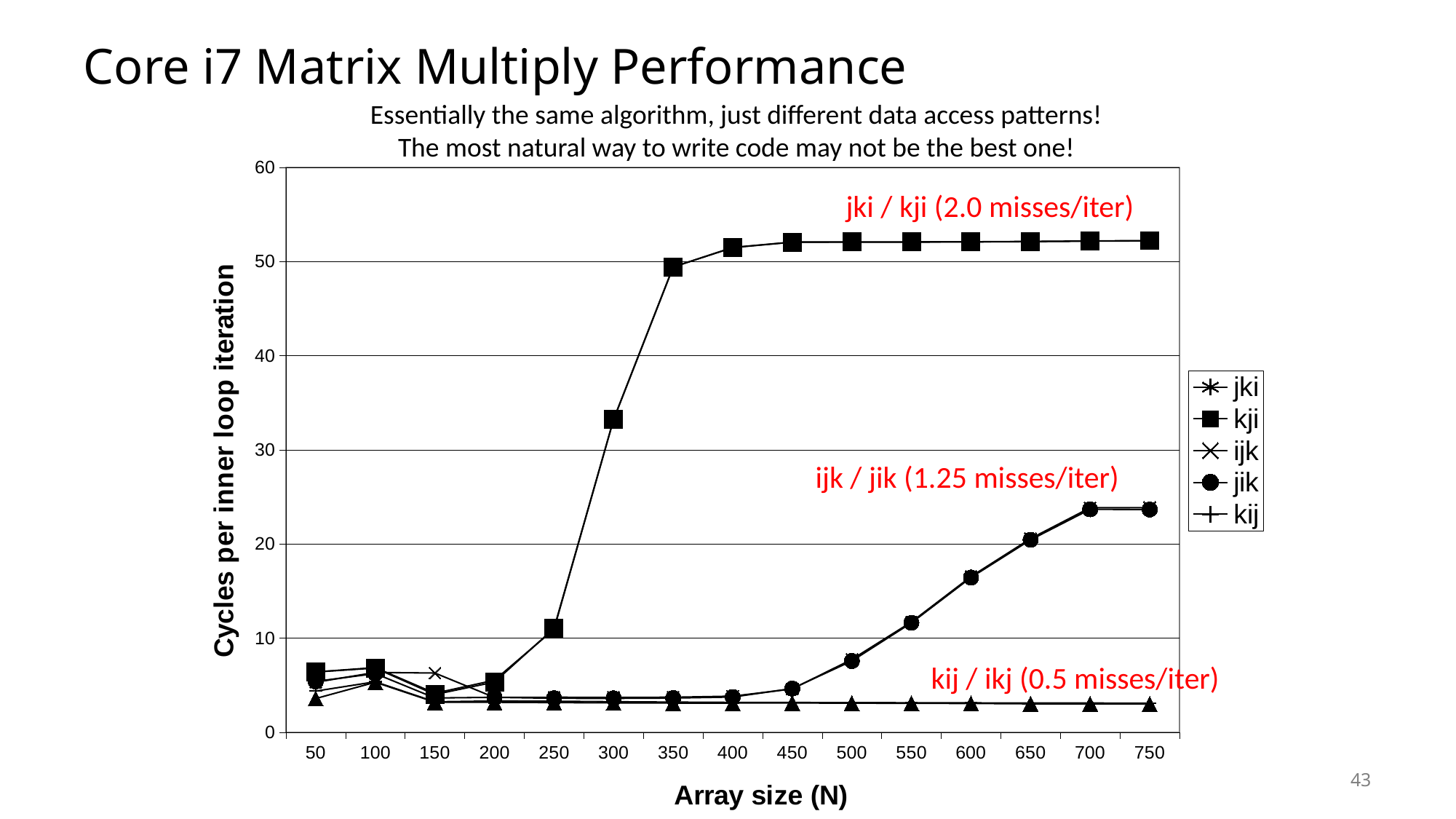
Is the value for jik at N = 500 greater or less than 10? less Is the value for kij at N = 750 greater or less than 10? less Is the value for kji at N = 300 greater or less than 30? greater How many array sizes (N) are plotted along the x axis? 15 Which series has the highest value at N = 750? kji What kind of chart is shown on the slide? line chart How many series does the legend list? 5 What is the title of the x axis? Array size (N) Do the values for kji rise or fall as the array size increases from 200 to 450? rise